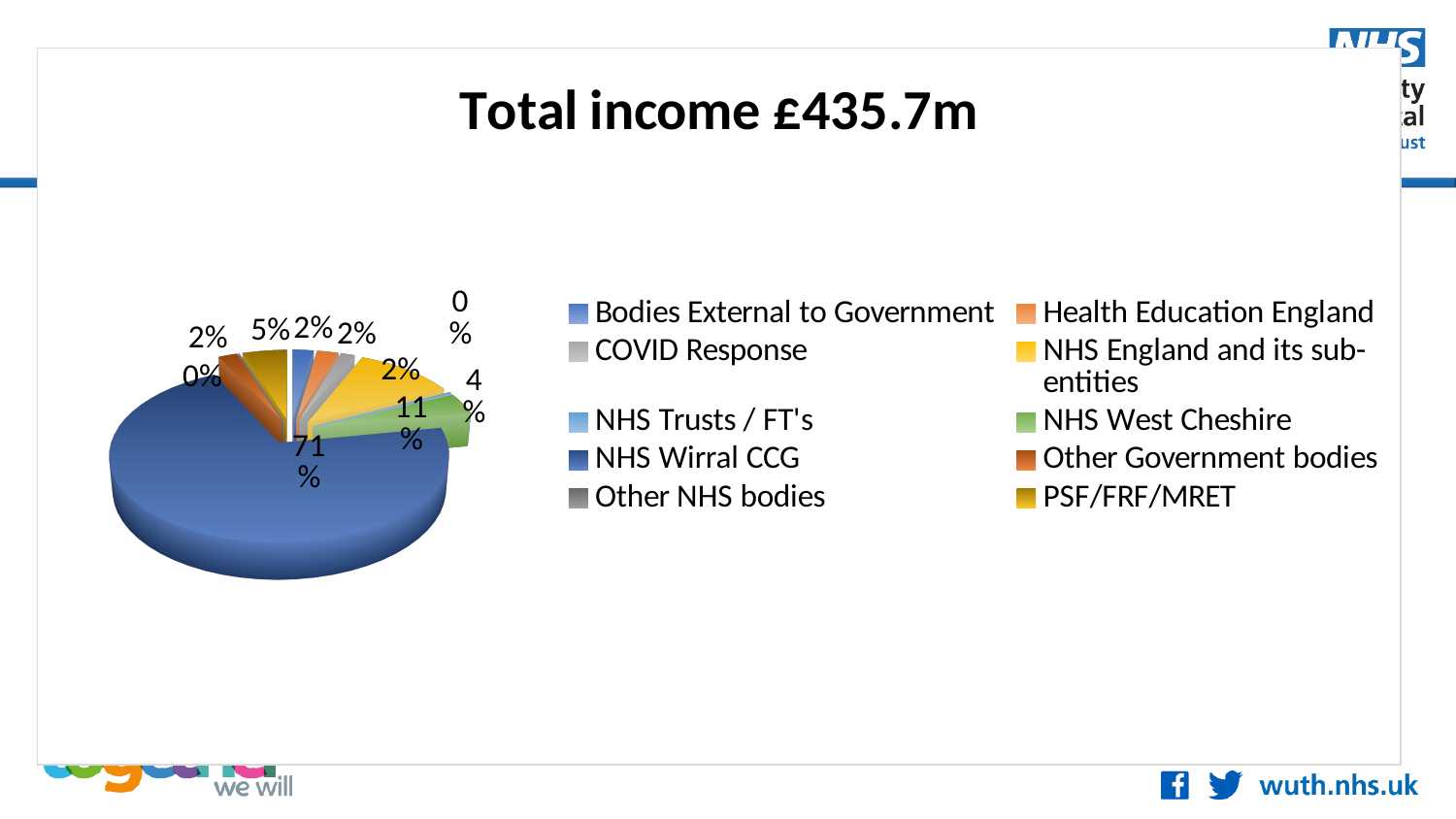
What share of total income comes from PSF/FRF/MRET? 5% How many categories does the legend list? 10 What colour is the NHS Wirral CCG slice? dark blue How many percentage points larger is the NHS England and its sub-entities share than the NHS West Cheshire share? 7 percentage points Which category has the largest share of the pie? NHS Wirral CCG What is the title of the chart? Total income £435.7m What share of total income comes from NHS West Cheshire? 4% Which has the larger share: NHS England and its sub-entities or NHS West Cheshire? NHS England and its sub-entities What share of total income comes from NHS England and its sub-entities? 11% What kind of chart is shown on the slide? pie chart How many percentage points larger is the NHS Wirral CCG share than the NHS England and its sub-entities share? 60 percentage points